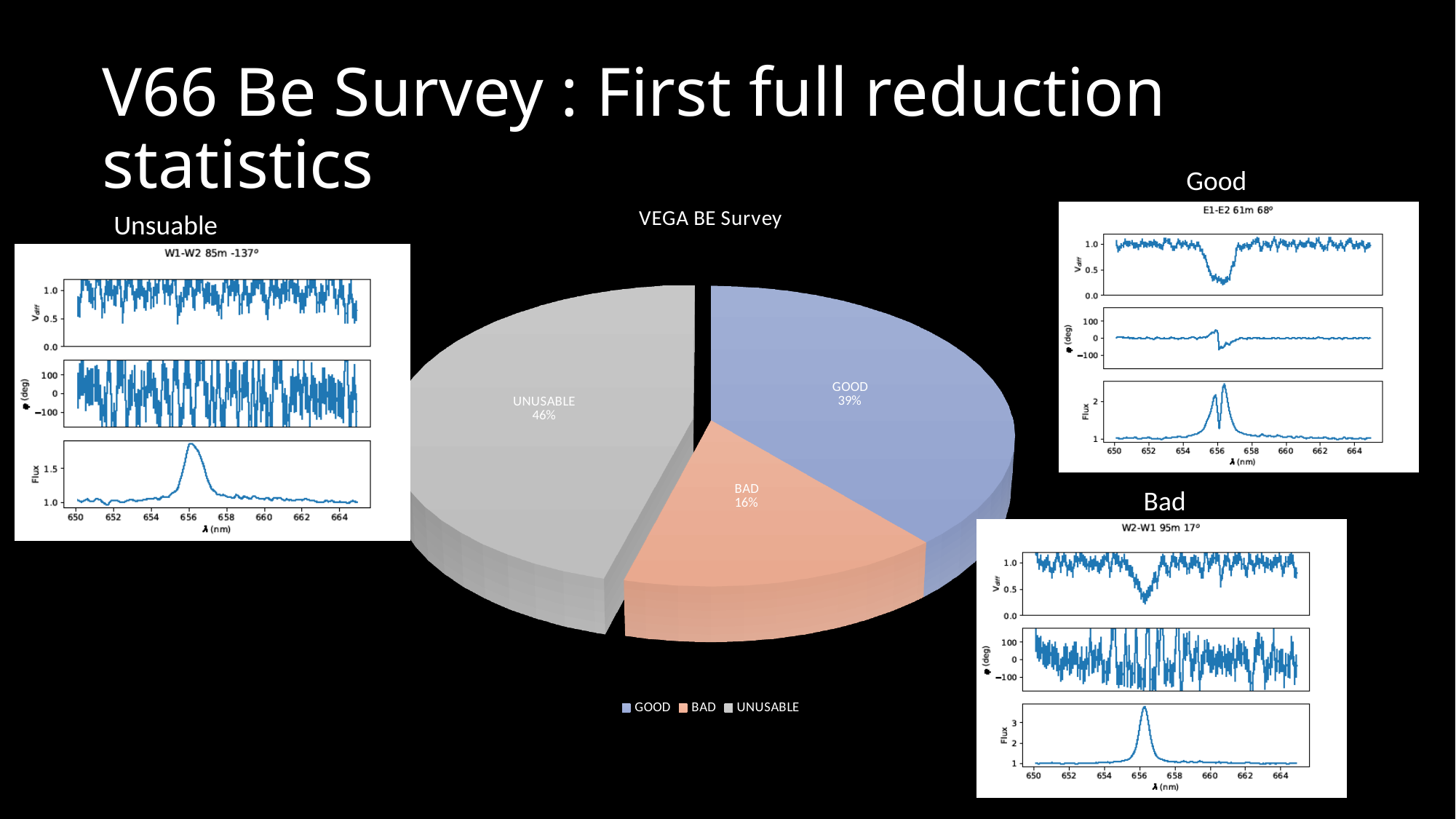
In the VEGA BE Survey pie chart, which category has the largest slice? UNUSABLE In the VEGA BE Survey pie chart, what colour is the UNUSABLE slice? Grey What kind of chart is the VEGA BE Survey chart in the centre of the slide? Pie chart In the VEGA BE Survey pie chart, which category has the smallest slice? BAD In the VEGA BE Survey pie chart, what share is labelled BAD? 16% In the VEGA BE Survey pie chart, what share is labelled UNUSABLE? 46% What is the title of the pie chart in the centre of the slide? VEGA BE Survey In the VEGA BE Survey pie chart, which slice is larger, GOOD or BAD? GOOD In the VEGA BE Survey pie chart, what is the difference in percentage points between the UNUSABLE and GOOD slices? 7 In the VEGA BE Survey pie chart, what share is labelled GOOD? 39% In the VEGA BE Survey pie chart, how many categories are shown? 3 In the VEGA BE Survey pie chart, what is the difference in percentage points between the GOOD and BAD slices? 23